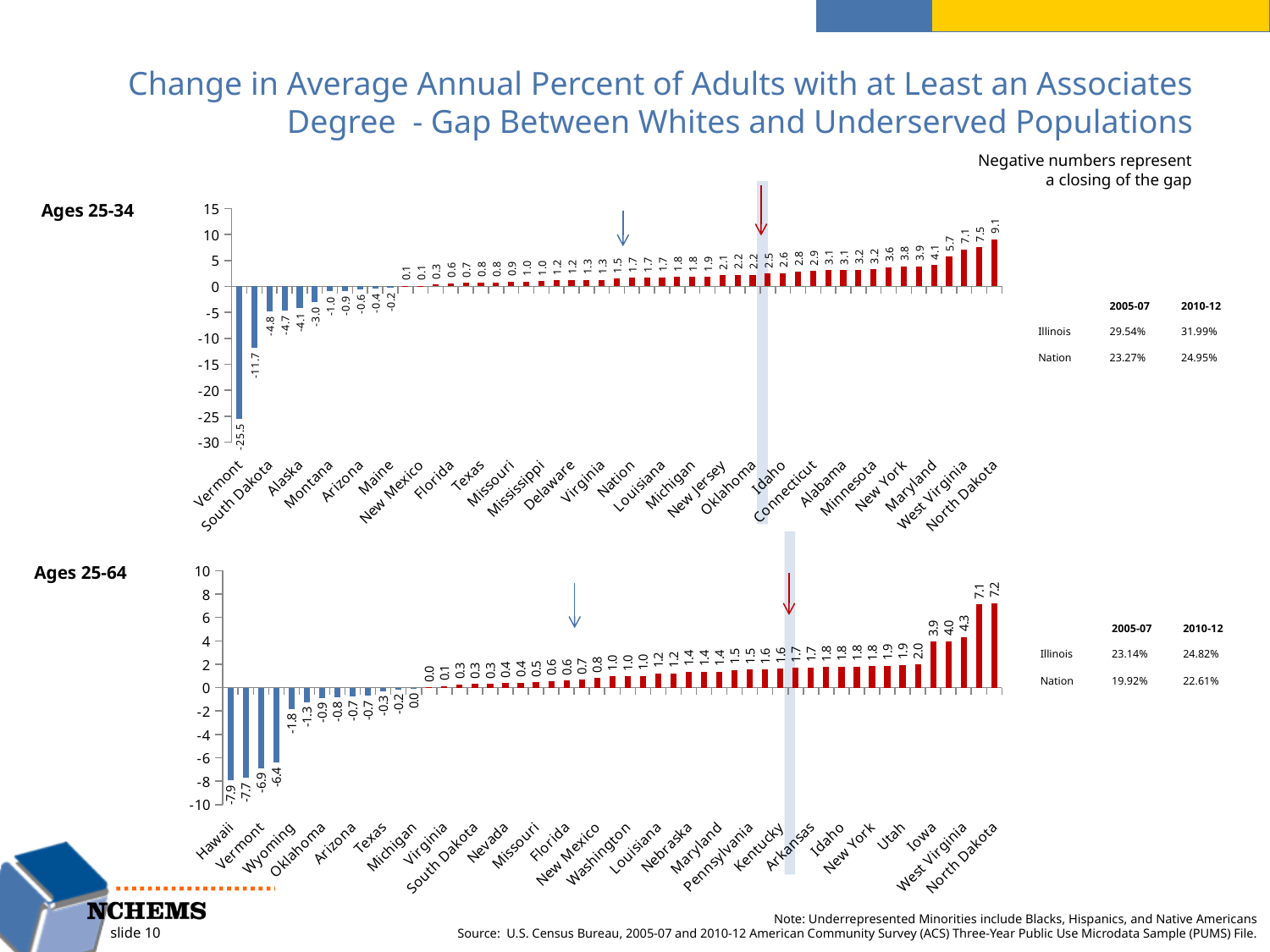
In the Ages 25-64 chart, what is the lowest value shown? -7.9 In the Ages 25-34 chart, what is the difference between the highest value (9.1) and the lowest value (-25.5)? 34.6 According to the table next to the Ages 25-34 chart, what is the Illinois value for 2010-12? 31.99% In the Ages 25-34 chart, is the value for Vermont greater or less than -20? less In the Ages 25-34 chart, what is the lowest value shown? -25.5 In the Ages 25-34 chart, what is the highest value shown? 9.1 What type of chart is used on this slide for the Ages 25-34 data? bar chart Which chart has the larger maximum value, Ages 25-34 or Ages 25-64? Ages 25-34 In the Ages 25-64 chart, which state has the lowest value? Hawaii In the Ages 25-64 chart, what is the highest value shown? 7.2 In the Ages 25-64 chart, do the bar values rise or fall from left to right along the x axis? rise